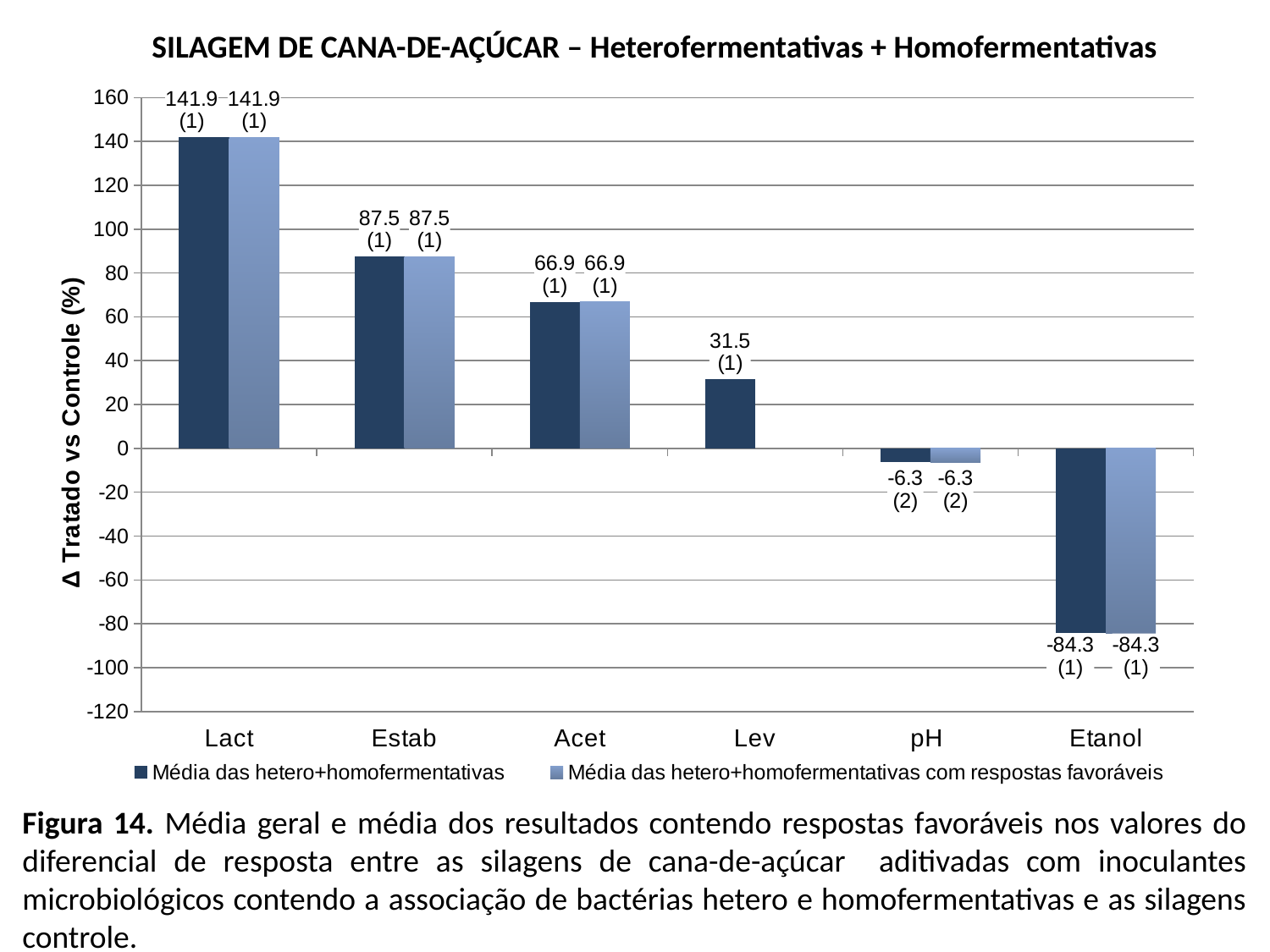
What is the difference between the Lact and Estab values in the 'Média das hetero+homofermentativas' series? 54.4 What is the value for Lev in the 'Média das hetero+homofermentativas' series? 31.5 What is the label of the y axis? Δ Tratado vs Controle (%) Which is larger in the 'Média das hetero+homofermentativas' series: Acet or Lev? Acet What kind of chart is shown on the slide? Bar chart Which category has the highest value in the 'Média das hetero+homofermentativas' series? Lact Which category has the lowest value in the 'Média das hetero+homofermentativas' series? Etanol What is the value for Lact in the 'Média das hetero+homofermentativas' series? 141.9 How many categories are shown on the x axis? 6 What is the value for Etanol in the 'Média das hetero+homofermentativas' series? -84.3 How many series does the legend list? 2 What is the value for Estab in the 'Média das hetero+homofermentativas com respostas favoráveis' series? 87.5